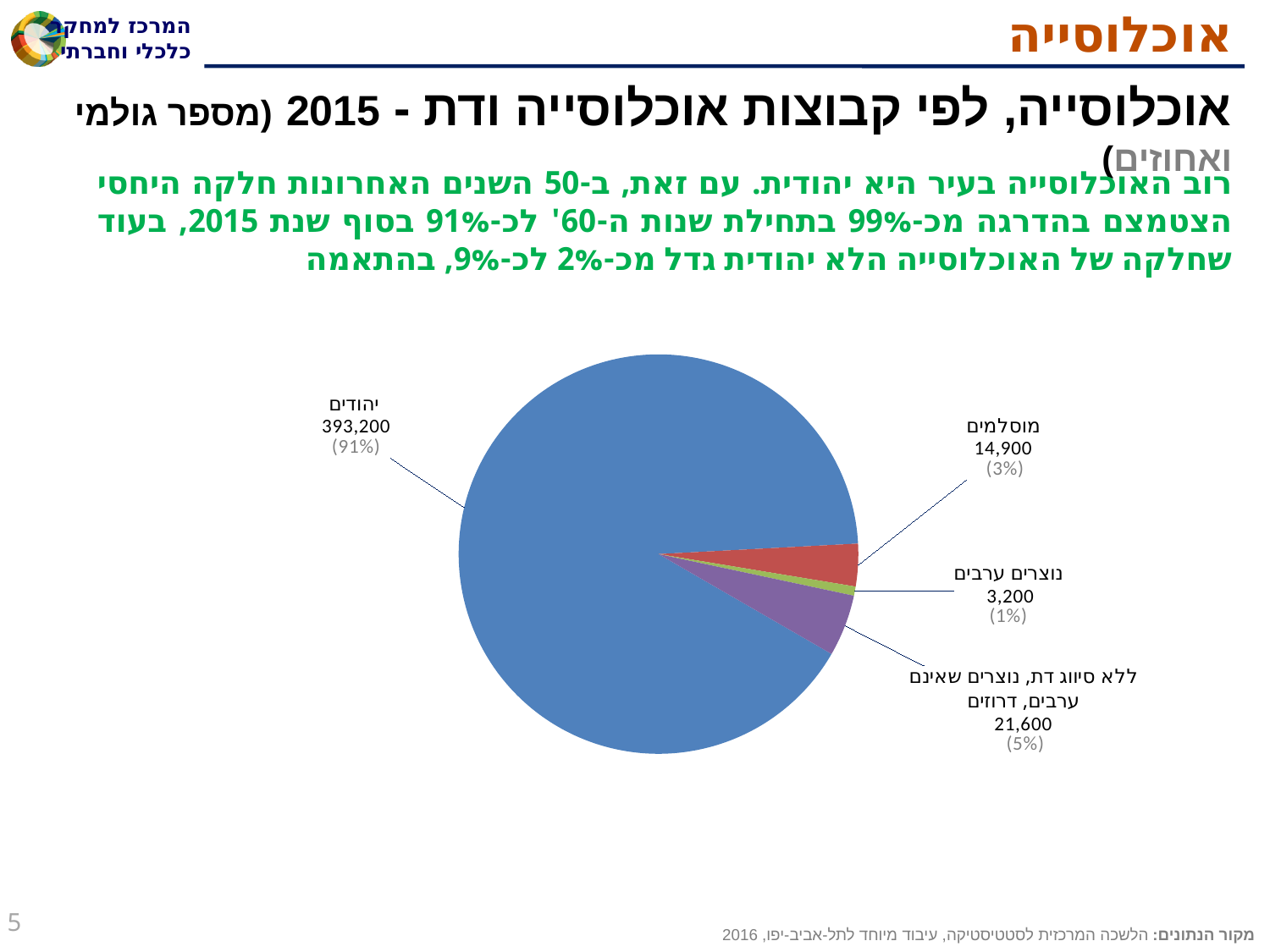
What is the value shown for יהודים (Jews) in the pie chart? 393,200 What share of the pie does the מוסלמים (Muslims) slice represent? 3% What is the value shown for the slice labelled ללא סיווג דת, נוצרים שאינם ערבים, דרוזים? 21,600 Which category has the largest slice in the pie chart? יהודים Which category has the smallest slice in the pie chart? נוצרים ערבים What share of the pie does the יהודים (Jews) slice represent? 91% What is the value shown for נוצרים ערבים (Arab Christians) in the pie chart? 3,200 How many slices does the pie chart have? 4 What kind of chart is shown on the slide? pie chart What is the difference between the values for מוסלמים (Muslims) and נוצרים ערבים (Arab Christians)? 11,700 What is the value shown for מוסלמים (Muslims) in the pie chart? 14,900 Which is larger: the value for מוסלמים (Muslims) or the value for ללא סיווג דת, נוצרים שאינם ערבים, דרוזים? ללא סיווג דת, נוצרים שאינם ערבים, דרוזים